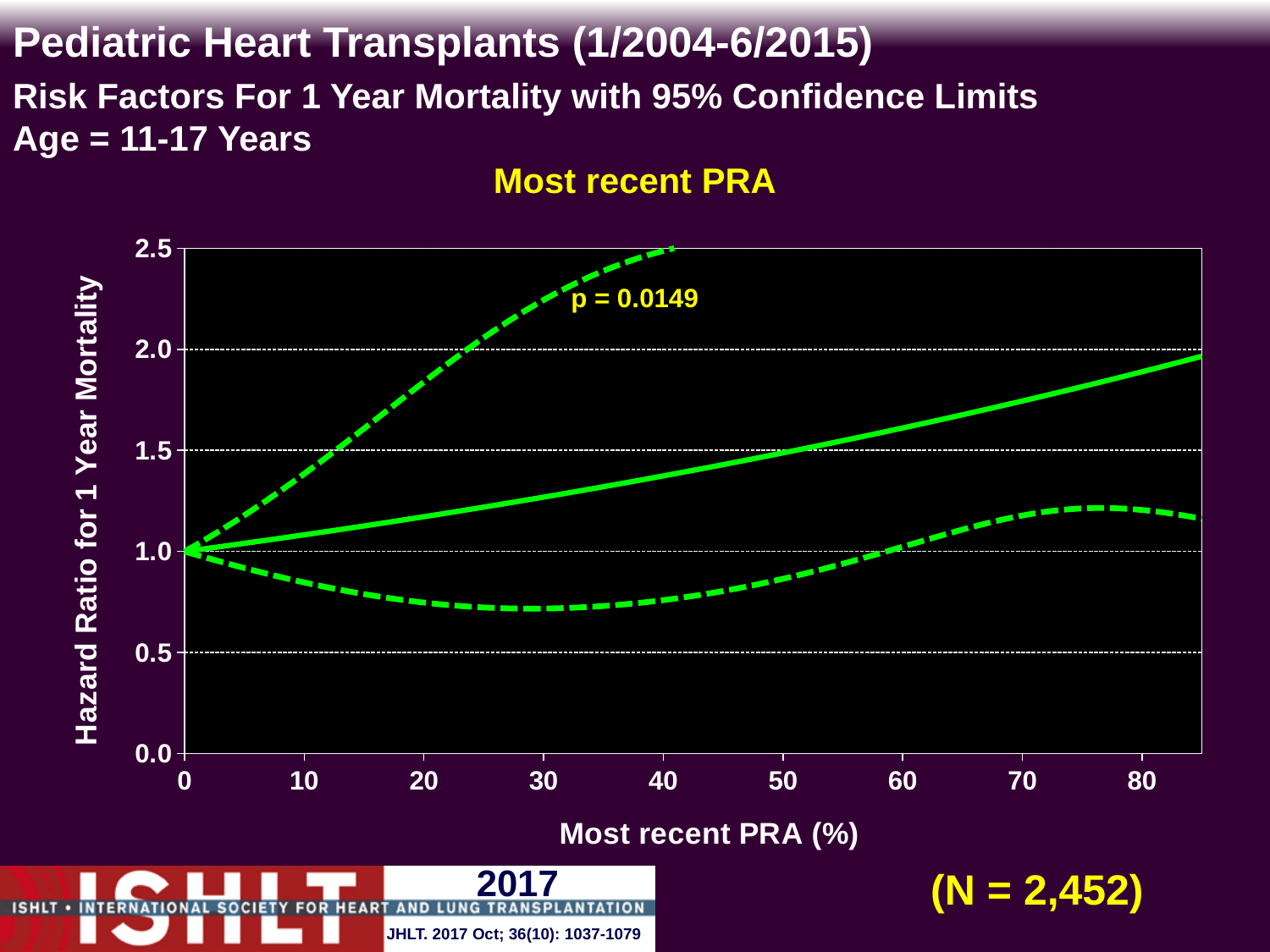
What kind of chart is shown on the slide? line chart What p-value is printed on the chart? p = 0.0149 What is the title shown above the chart? Most recent PRA How many lines are plotted on the chart? 3 Is the upper dashed confidence limit at a most recent PRA of 30% greater or less than 2.0? greater What is the hazard ratio for 1 year mortality at a most recent PRA of 0%? 1.0 Is the hazard ratio on the solid line at a most recent PRA of 40% greater or less than 1.5? less Is the lower dashed confidence limit at a most recent PRA of 30% greater or less than 1.0? less Does the solid hazard ratio line rise or fall as most recent PRA increases? rises What is the maximum value shown on the y axis of the chart? 2.5